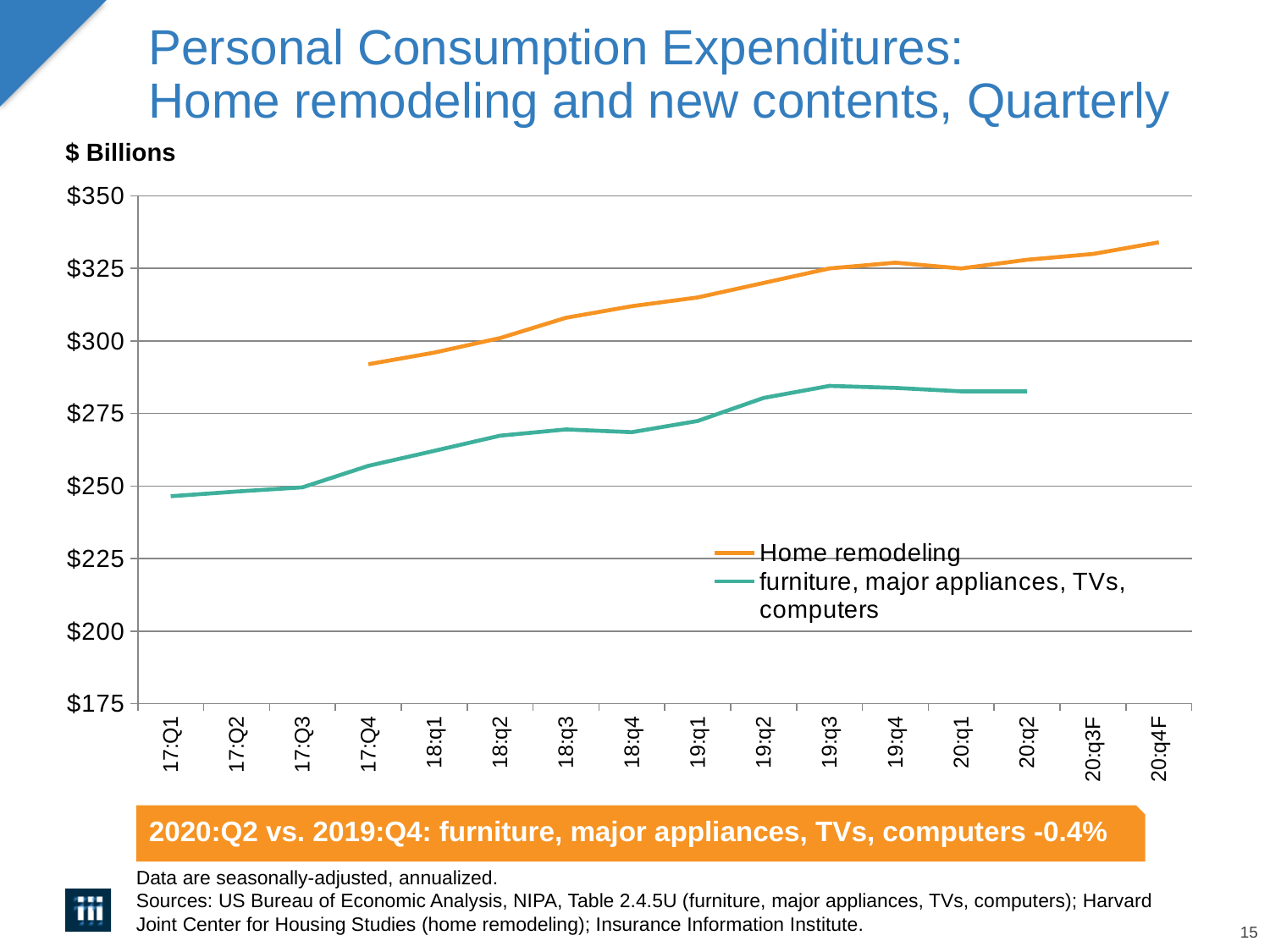
How many quarters are labeled along the x axis? 16 Is the Home remodeling value for 20:q4F greater or less than $325? greater Which quarter has the highest value for the Home remodeling series? 20:q4F Which quarter has the lowest value for the Home remodeling series? 17:Q4 Is the Home remodeling value for 17:Q4 greater or less than $300? less What kind of chart is shown on the slide? line chart Is the furniture, major appliances, TVs, computers value for 19:q3 greater or less than $275? greater At 19:q3, which series has the larger value, Home remodeling or furniture, major appliances, TVs, computers? Home remodeling How many series does the legend list? 2 Does the Home remodeling series generally rise or fall from 17:Q4 to 20:q4F? rise Which quarter has the lowest value for the furniture, major appliances, TVs, computers series? 17:Q1